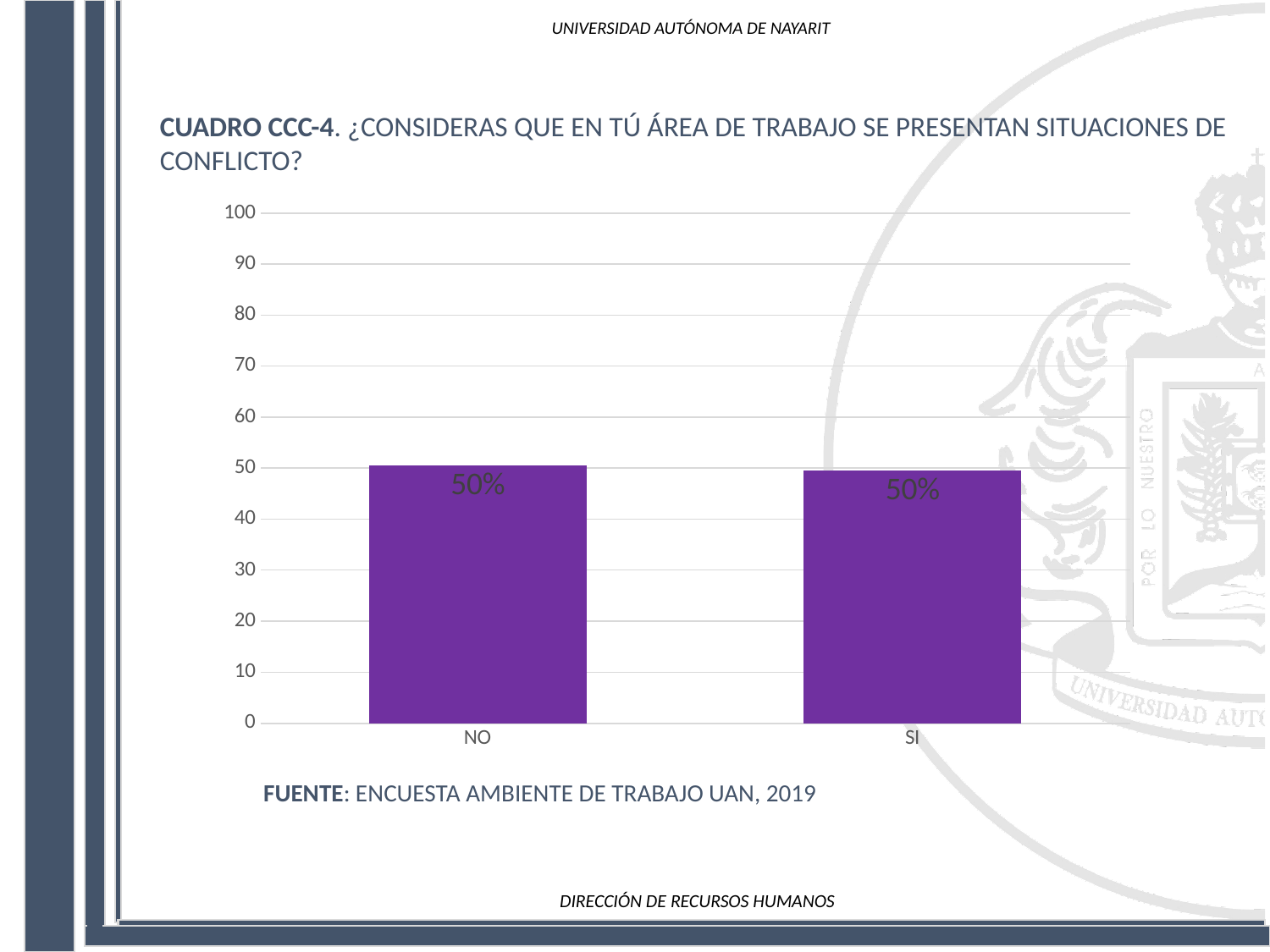
What is the difference between the values for NO and SI? 0 What is the highest value shown on the y axis? 100 Is the value for NO greater or less than 80? less What colour are the bars in the chart? purple What is the value for NO? 50% Is the value for SI greater or less than 20? greater How many categories are shown on the x axis? 2 What kind of chart is shown on the slide? bar chart What is the total of the values for NO and SI? 100% What is the value for SI? 50%